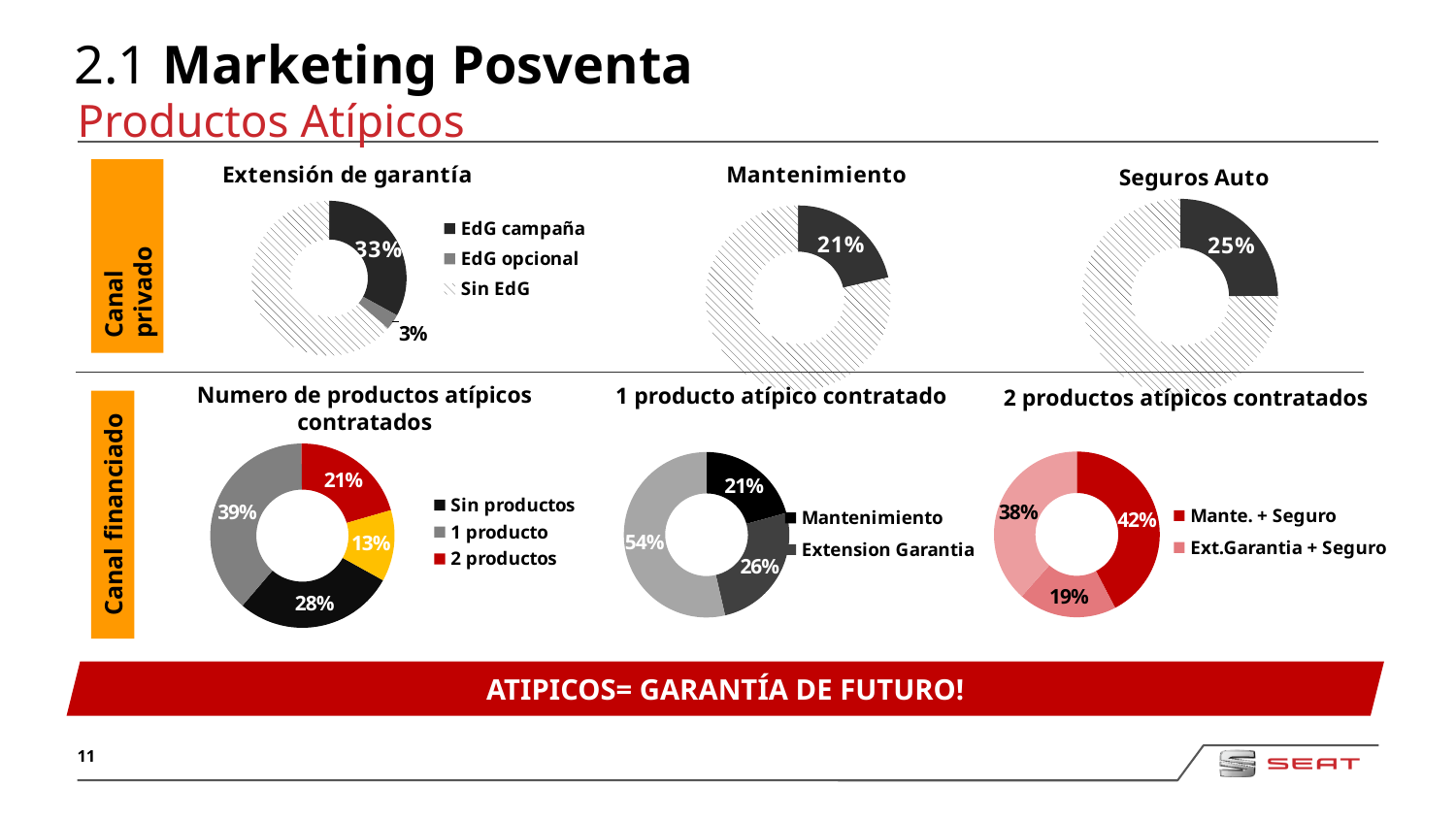
In the 'Extensión de garantía' chart, what is the difference in percentage points between EdG campaña and EdG opcional? 30 percentage points In the 'Extensión de garantía' chart, what percentage is shown for EdG opcional? 3% In the 'Extensión de garantía' chart, what percentage is shown for EdG campaña? 33% In the 'Mantenimiento' chart, what percentage is printed on the dark slice? 21% What kind of chart is used for 'Seguros Auto'? Donut (pie) chart In the 'Numero de productos atípicos contratados' chart, what percentage is shown for 'Sin productos'? 28% In the '2 productos atípicos contratados' chart, what percentage is shown for 'Mante. + Seguro'? 42% In the '1 producto atípico contratado' chart, what is the difference in percentage points between Extension Garantia and Mantenimiento? 5 percentage points In the 'Numero de productos atípicos contratados' chart, what percentage is shown for '1 producto'? 39% In the 'Seguros Auto' chart, what percentage is printed on the dark slice? 25% Which is larger: the labeled slice in the 'Seguros Auto' chart or the labeled slice in the 'Mantenimiento' chart? Seguros Auto How many entries does the legend of the 'Extensión de garantía' chart list? 3